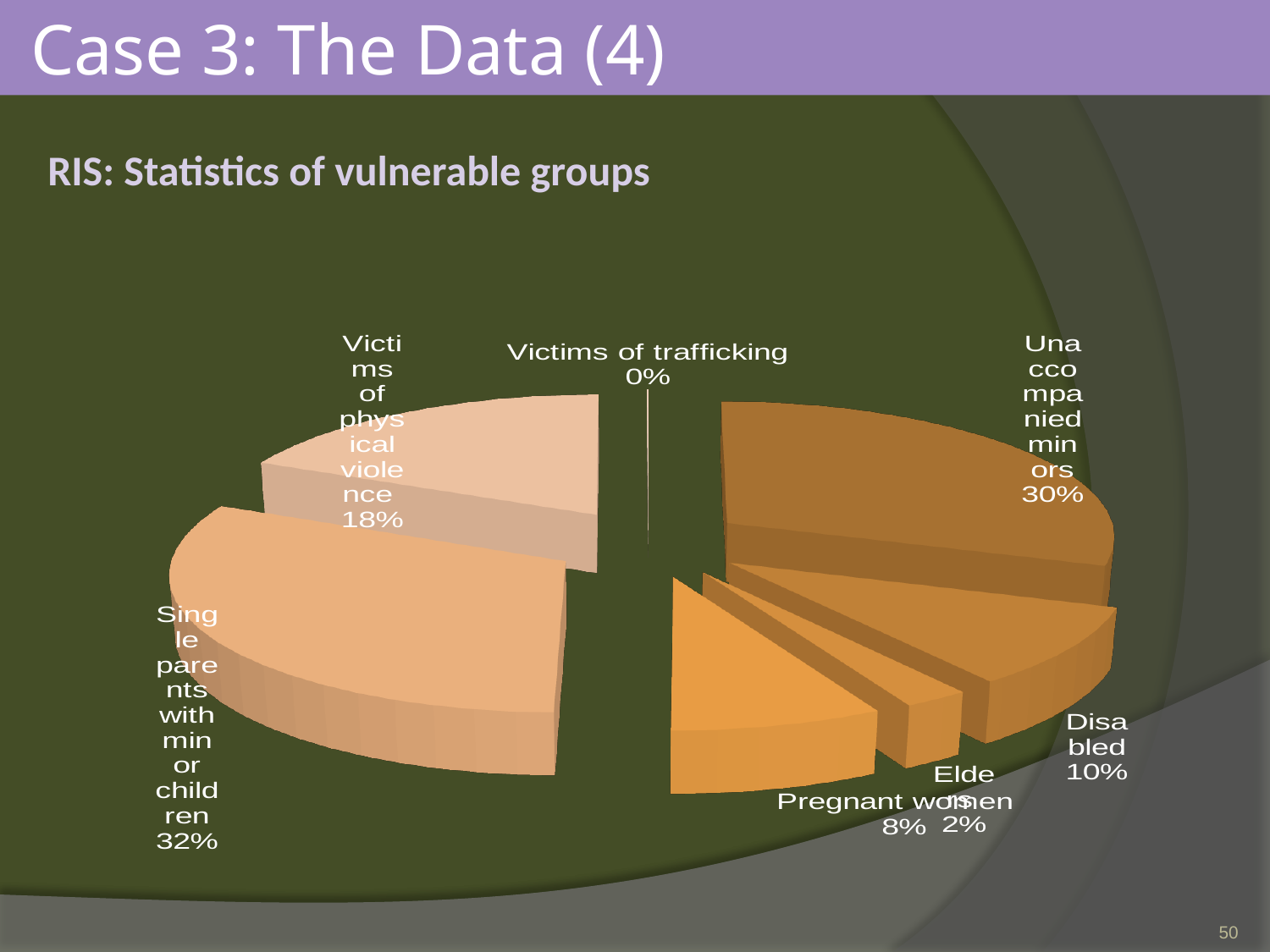
Which is larger, the share for Victims of physical violence or the share for Disabled? Victims of physical violence What percentage is shown for Disabled? 10% Which group has the smallest share of the pie? Victims of trafficking How many groups are shown in the pie chart? 7 What percentage is shown for Victims of trafficking? 0% What percentage is shown for Victims of physical violence? 18% What percentage is shown for Unaccompanied minors? 30% What percentage is shown for Pregnant women? 8% Which group has the largest share of the pie? Single parents with minor children What share of the pie is Single parents with minor children? 32% What kind of chart is shown on the slide? pie chart What is the difference in percentage points between Unaccompanied minors and Disabled? 20%